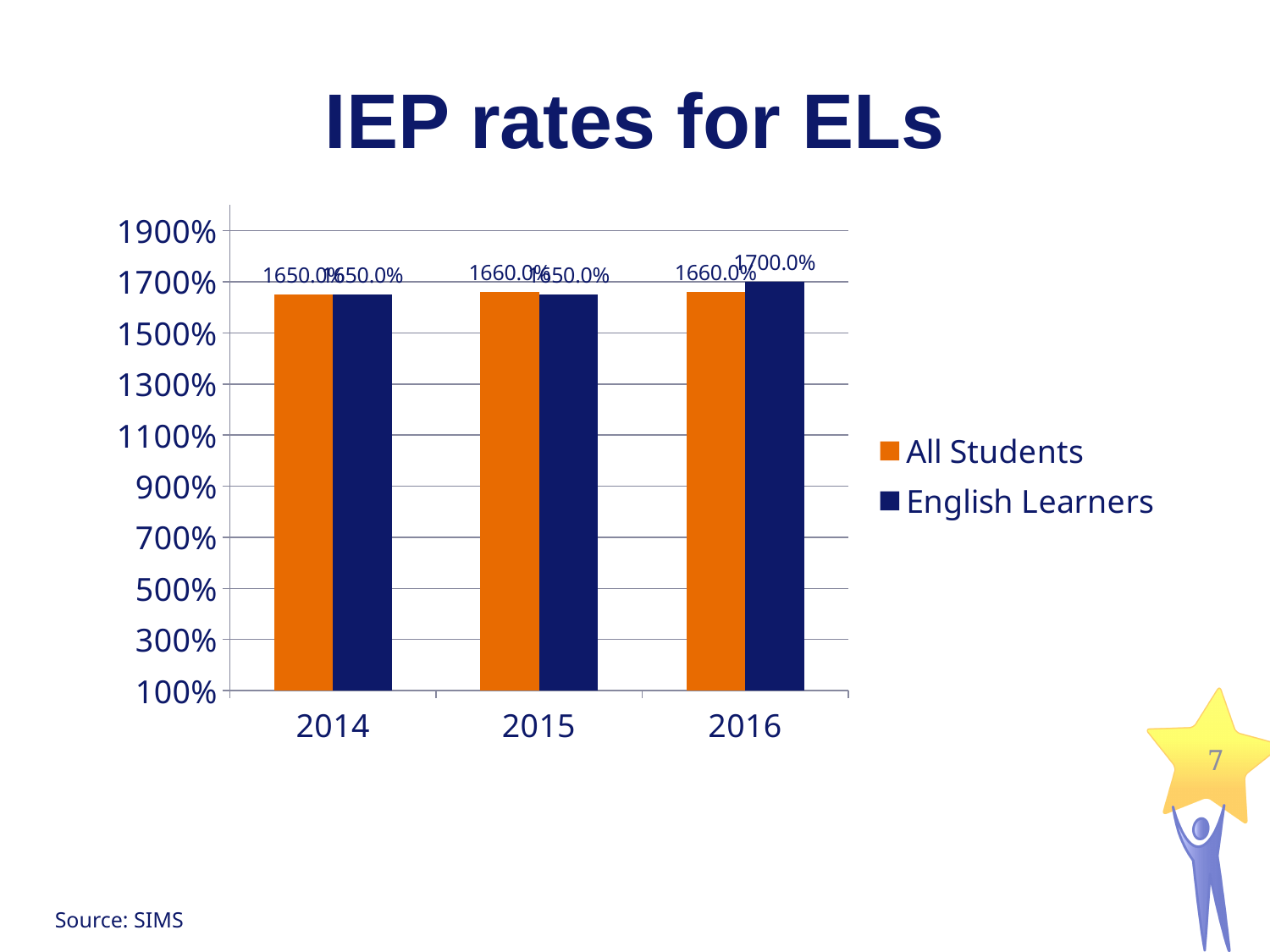
Is the value for All Students in 2014 greater or less than 1500%? greater What is the title of the chart? IEP rates for ELs What is the value for All Students in 2014? 1650.0% How many years are shown on the x axis? 3 Which colour represents English Learners in the legend? Dark blue What is the value for English Learners in 2016? 1700.0% In which year is the English Learners value highest? 2016 What is the value for All Students in 2015? 1660.0% How many series does the legend list? 2 What is the difference between English Learners and All Students in 2016? 40.0% In 2016, which is larger: All Students or English Learners? English Learners What type of chart is shown on the slide? Bar chart